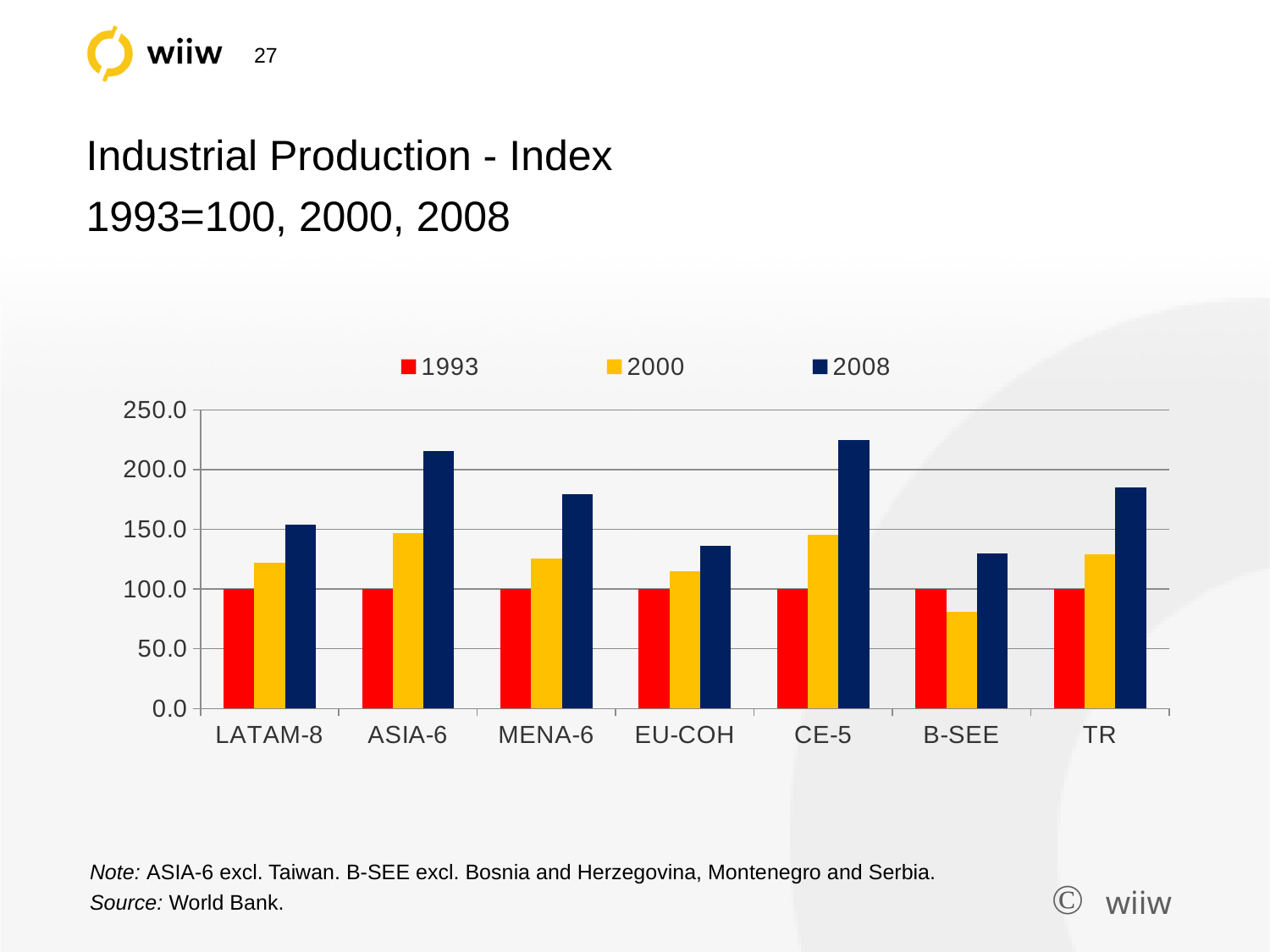
How many series does the legend list? 3 What is the 1993 value for CE-5? 100.0 Which category has the highest 2008 value? CE-5 What is the 1993 value for LATAM-8? 100.0 Is the 2008 value for EU-COH greater or less than 150.0? less Is the 2008 value for ASIA-6 greater or less than 200.0? greater Which category has the lowest 2000 value? B-SEE Which colour represents the 2008 series in the legend? dark blue What type of chart is shown on the slide? bar chart Which is larger, the 2008 value for CE-5 or the 2008 value for EU-COH? CE-5 Is the 2000 value for B-SEE greater or less than 100.0? less How many regional categories are shown on the x axis? 7